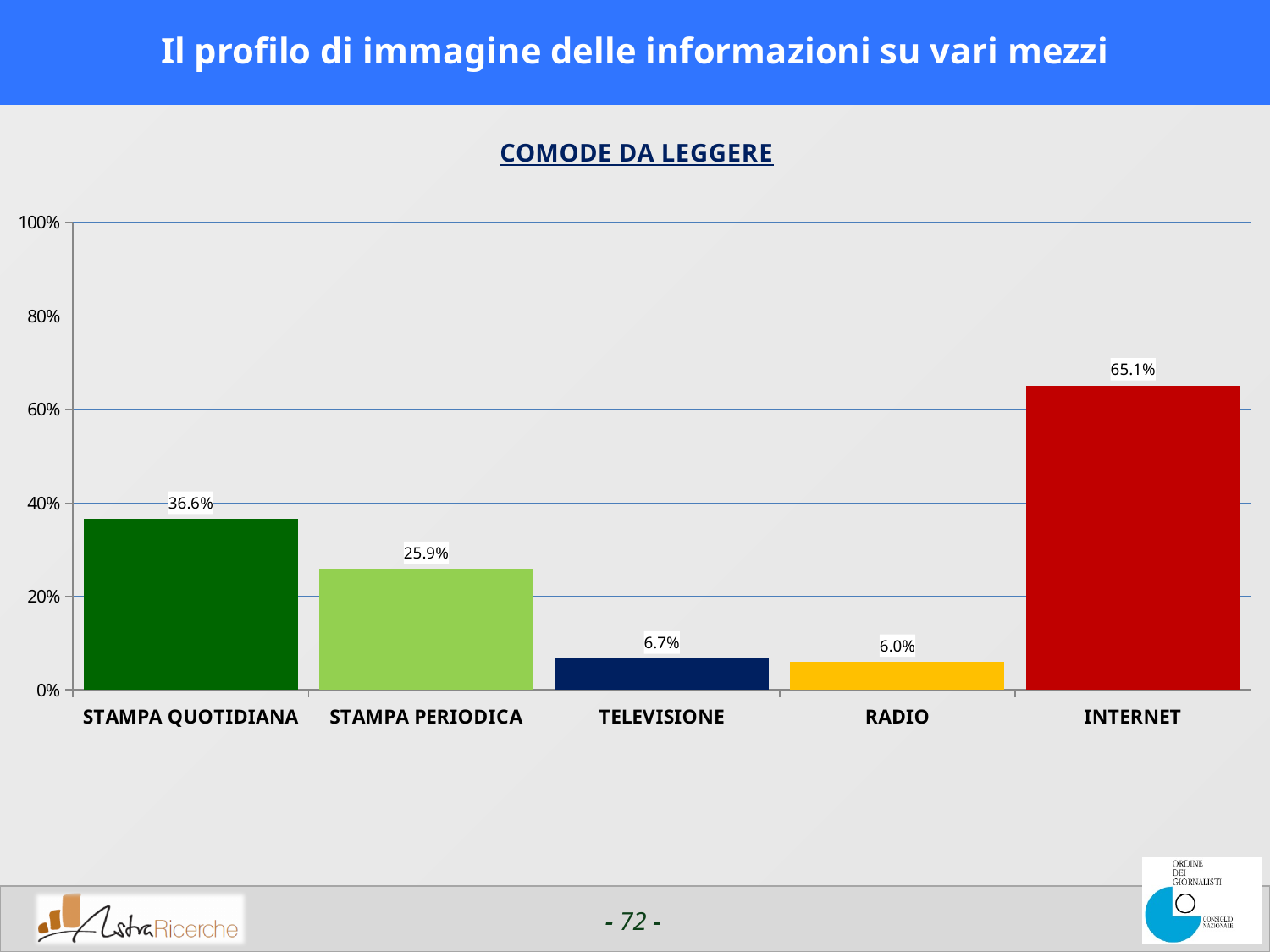
What is the value for INTERNET? 65.1% How many categories are shown on the x axis? 5 Which category has the highest value? INTERNET What is the title of the chart? COMODE DA LEGGERE Which category has the lowest value? RADIO Which is larger, the value for STAMPA PERIODICA or the value for TELEVISIONE? STAMPA PERIODICA What is the value for TELEVISIONE? 6.7% What is the difference between the values for INTERNET and STAMPA QUOTIDIANA? 28.5% What kind of chart is shown on the slide? Bar chart What is the value for RADIO? 6.0% What is the value for STAMPA QUOTIDIANA? 36.6% What is the difference between the values for STAMPA QUOTIDIANA and STAMPA PERIODICA? 10.7%